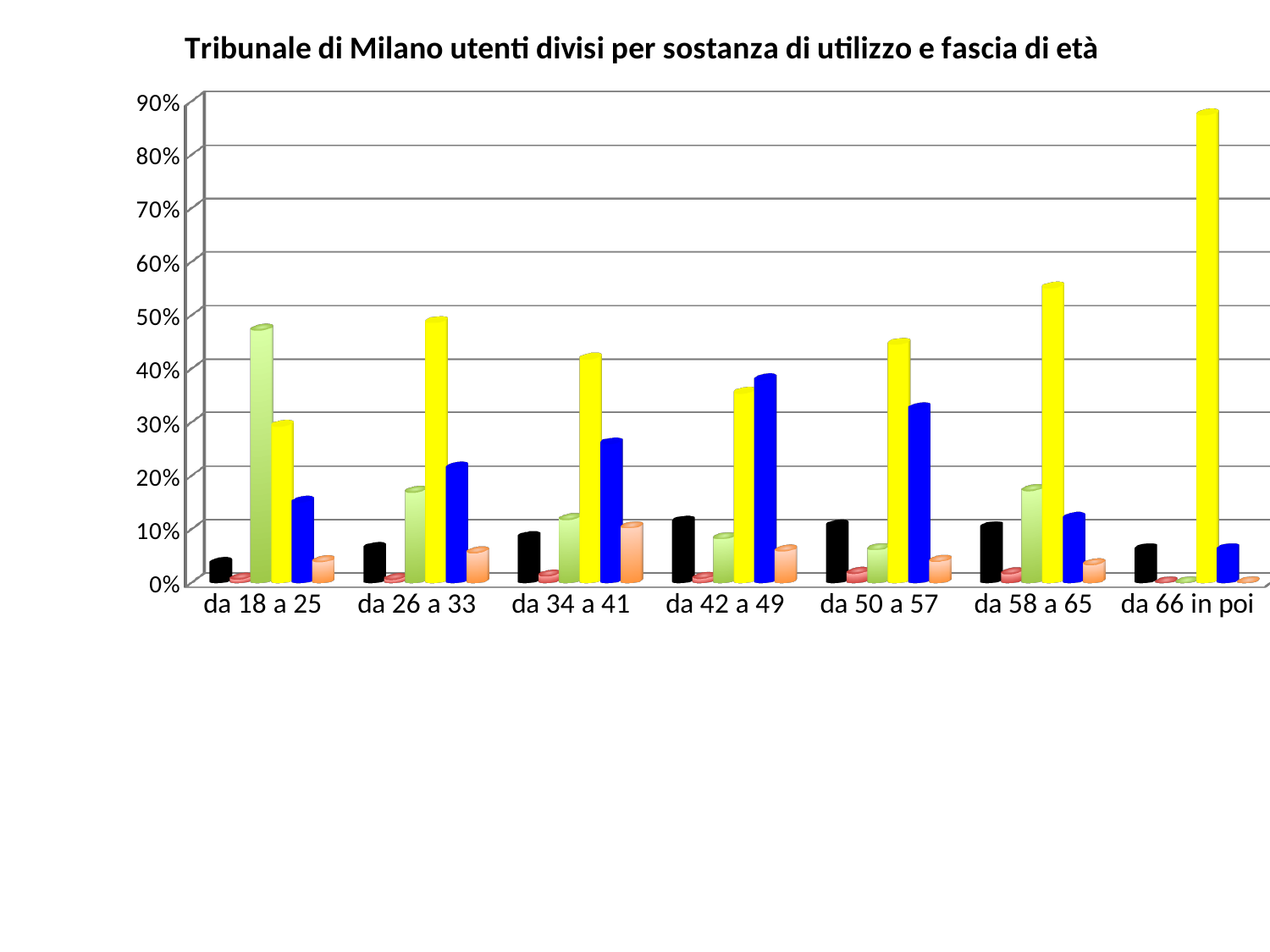
How many age-group categories are shown on the x axis? 7 Is the blue bar for 'da 42 a 49' greater or less than 30%? greater What is the title of the chart? Tribunale di Milano utenti divisi per sostanza di utilizzo e fascia di età What kind of chart is shown on the slide? bar chart Is the yellow bar for 'da 58 a 65' greater or less than 50%? greater In the 'da 50 a 57' group, which is larger, the yellow bar or the blue bar? yellow bar Is the yellow bar for 'da 66 in poi' greater or less than 80%? greater What is the highest value shown on the y axis? 90% Which age group has the tallest light green bar? da 18 a 25 Which age group has the tallest yellow bar? da 66 in poi